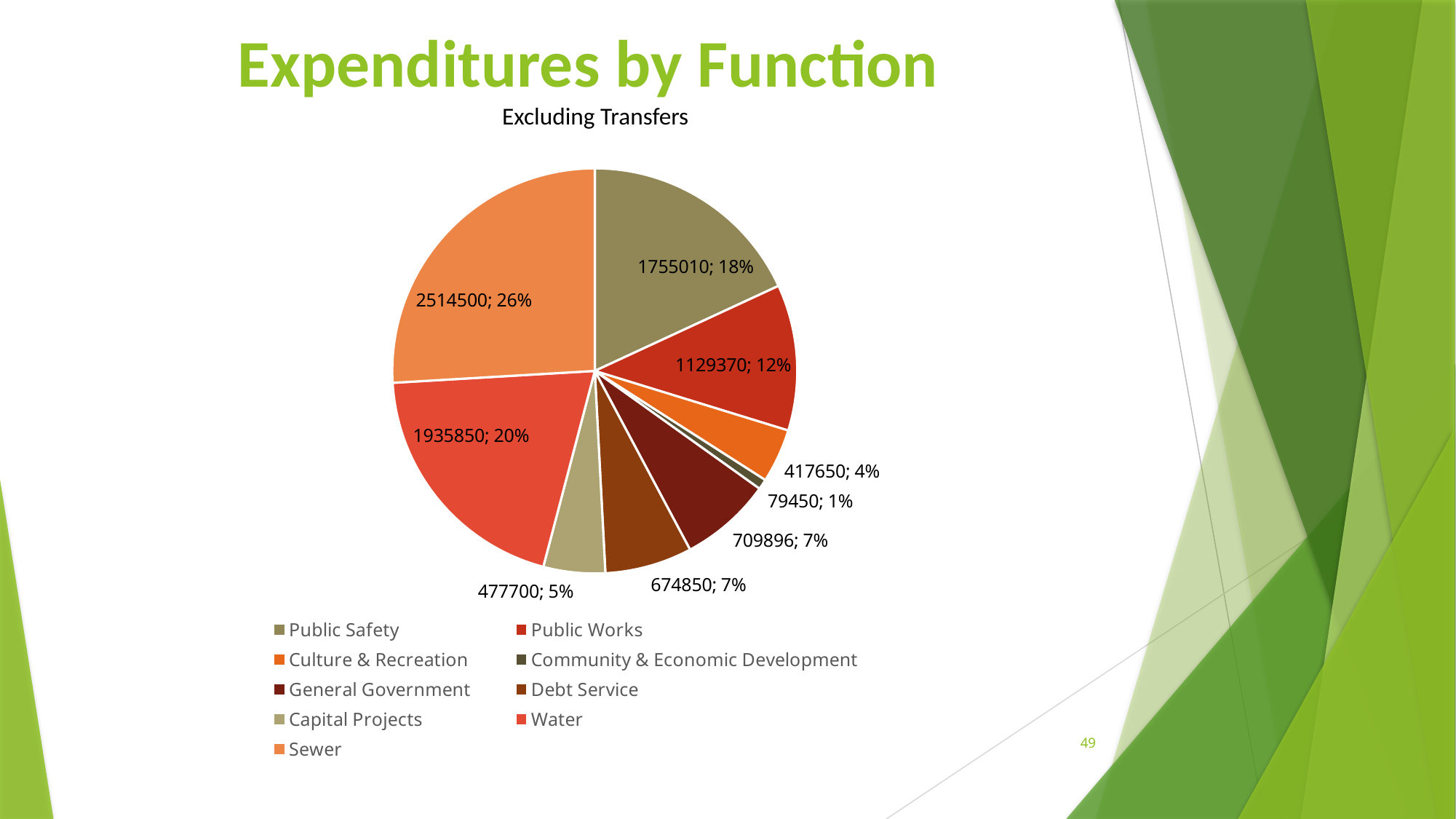
What is the value for Sewer? 2514500 What kind of chart is shown on the slide? Pie chart Which is larger, Culture & Recreation or Capital Projects? Capital Projects What is the value for Public Works? 1129370 How many categories does the legend list? 9 Which category has the largest share of expenditures? Sewer What is the value for General Government? 709896 What percentage share does Water have? 20% What percentage share does Public Safety have? 18% Which category has the smallest share of expenditures? Community & Economic Development What is the difference between the Water and Public Safety values? 180840 What is the subtitle shown above the pie chart? Excluding Transfers